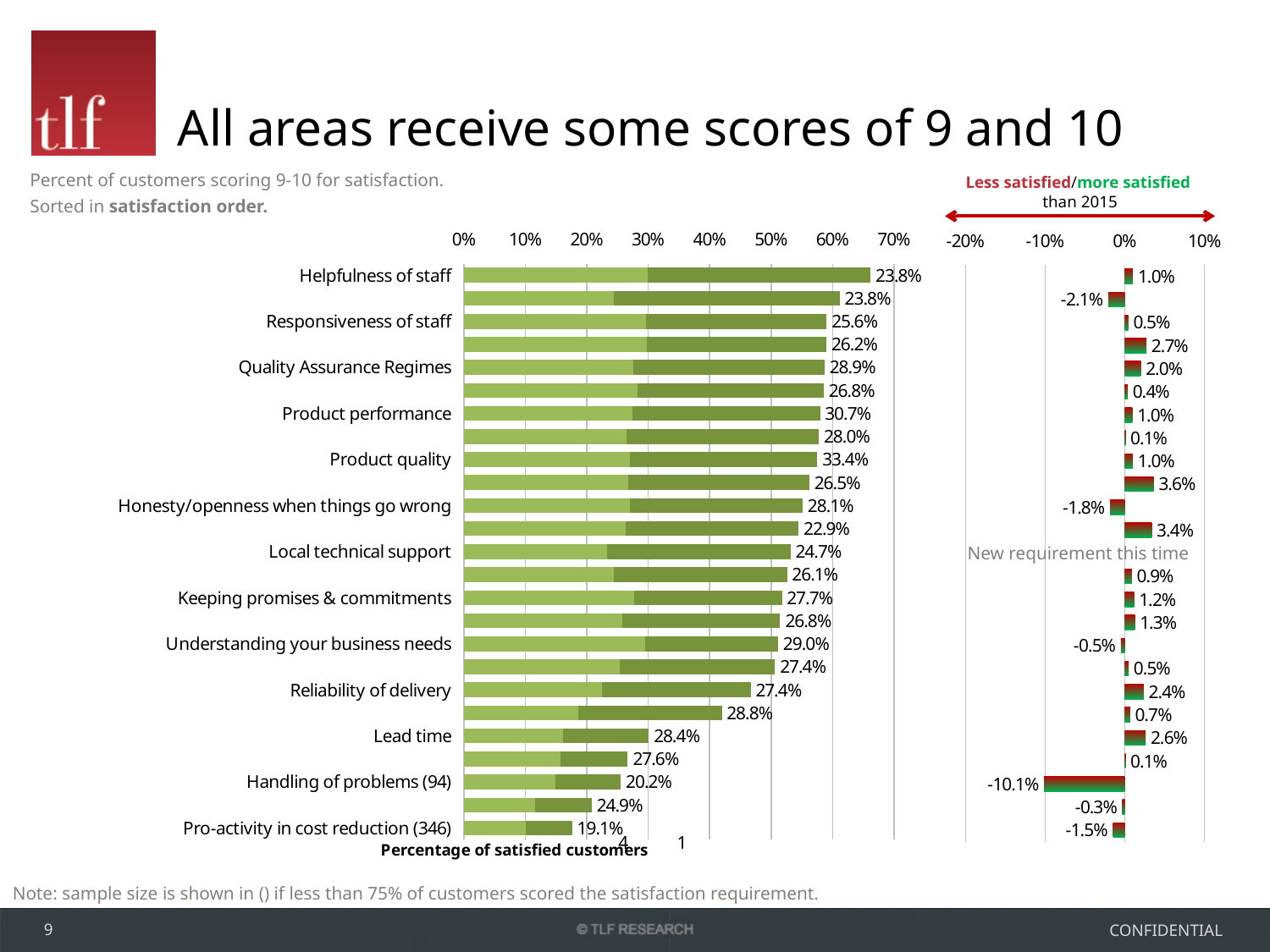
In the right-hand chart, what is the largest positive change since 2015 shown? 3.6% What data label is printed beside the bar aligned with 'Product quality' in the left-hand chart? 33.4% Which category is listed first (at the top) of the left-hand chart? Helpfulness of staff How many category labels are listed down the left side of the chart? 13 In the right-hand chart, what is the change since 2015 shown for 'Handling of problems (94)'? -10.1% In the left-hand chart, is the total bar length for 'Helpfulness of staff' greater or less than 60%? greater What is the difference between the data label beside 'Product quality' (33.4%) and the data label beside 'Pro-activity in cost reduction (346)' (19.1%) in the left-hand chart? 14.3% What kind of chart is used on the left side of the slide to show the percentage of satisfied customers? Bar chart In the right-hand chart showing change since 2015, which category has the largest decrease? Handling of problems (94) In the left-hand chart, is the total bar length for 'Pro-activity in cost reduction (346)' greater or less than 20%? less Which category in the right-hand chart is marked 'New requirement this time' instead of a change value? Local technical support What data label is printed beside the bar aligned with 'Pro-activity in cost reduction (346)' in the left-hand chart? 19.1%